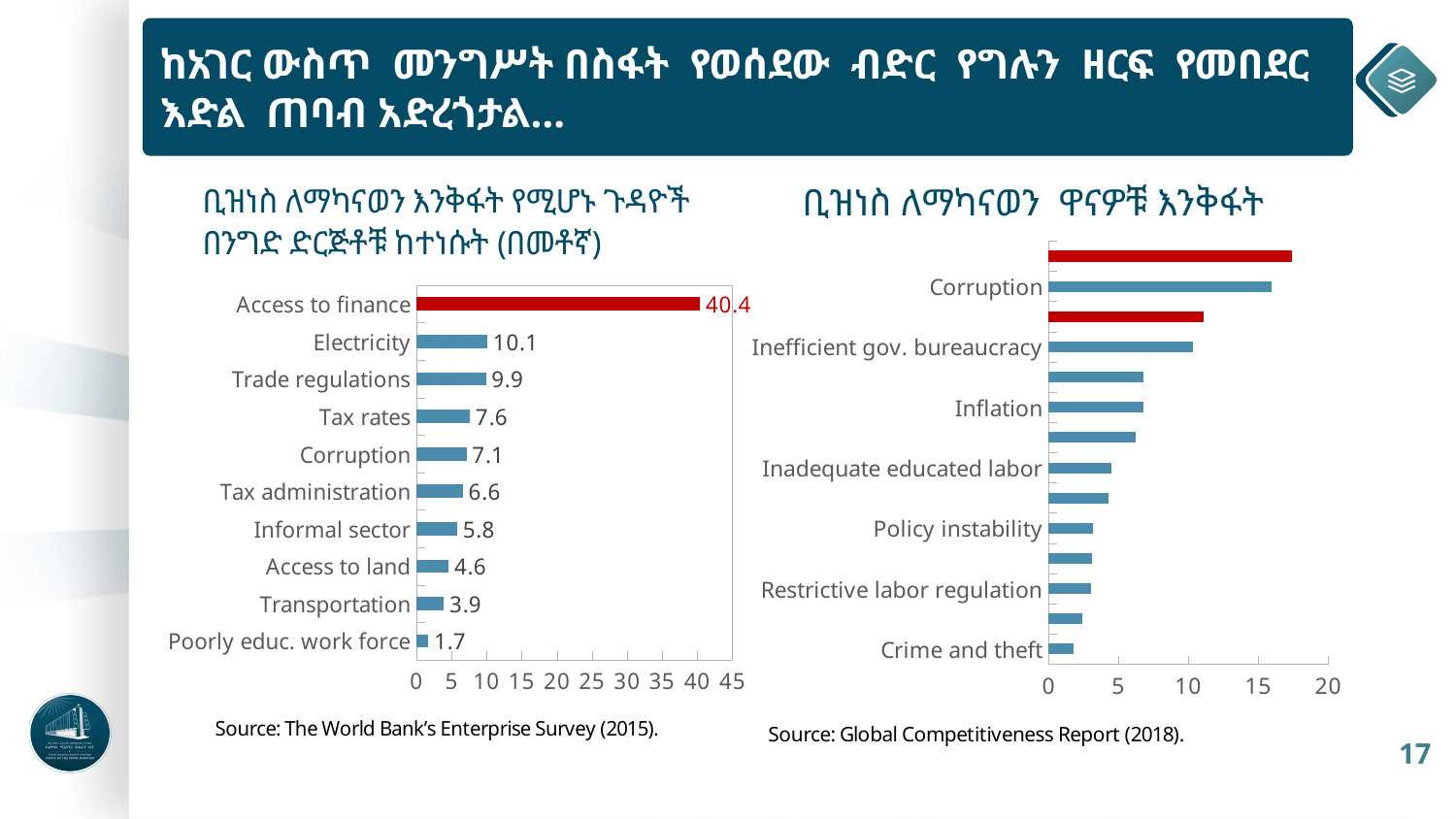
On the left chart, what is the value for Corruption? 7.1 What kind of chart is the left chart? Bar chart On the left chart, what is the value for Transportation? 3.9 What source is cited below the right chart? Global Competitiveness Report (2018) On the right chart, is the value for Corruption greater or less than 15? greater On the right chart, is the value for Crime and theft greater or less than 5? less On the left chart, which category has the lowest value? Poorly educ. work force On the left chart, which is larger, the value for Tax rates or the value for Informal sector? Tax rates How many categories are shown on the left chart? 10 On the left chart, what is the difference between the values for Electricity and Trade regulations? 0.2 On the left chart, which category has the highest value? Access to finance On the left chart, what is the value for Access to finance? 40.4